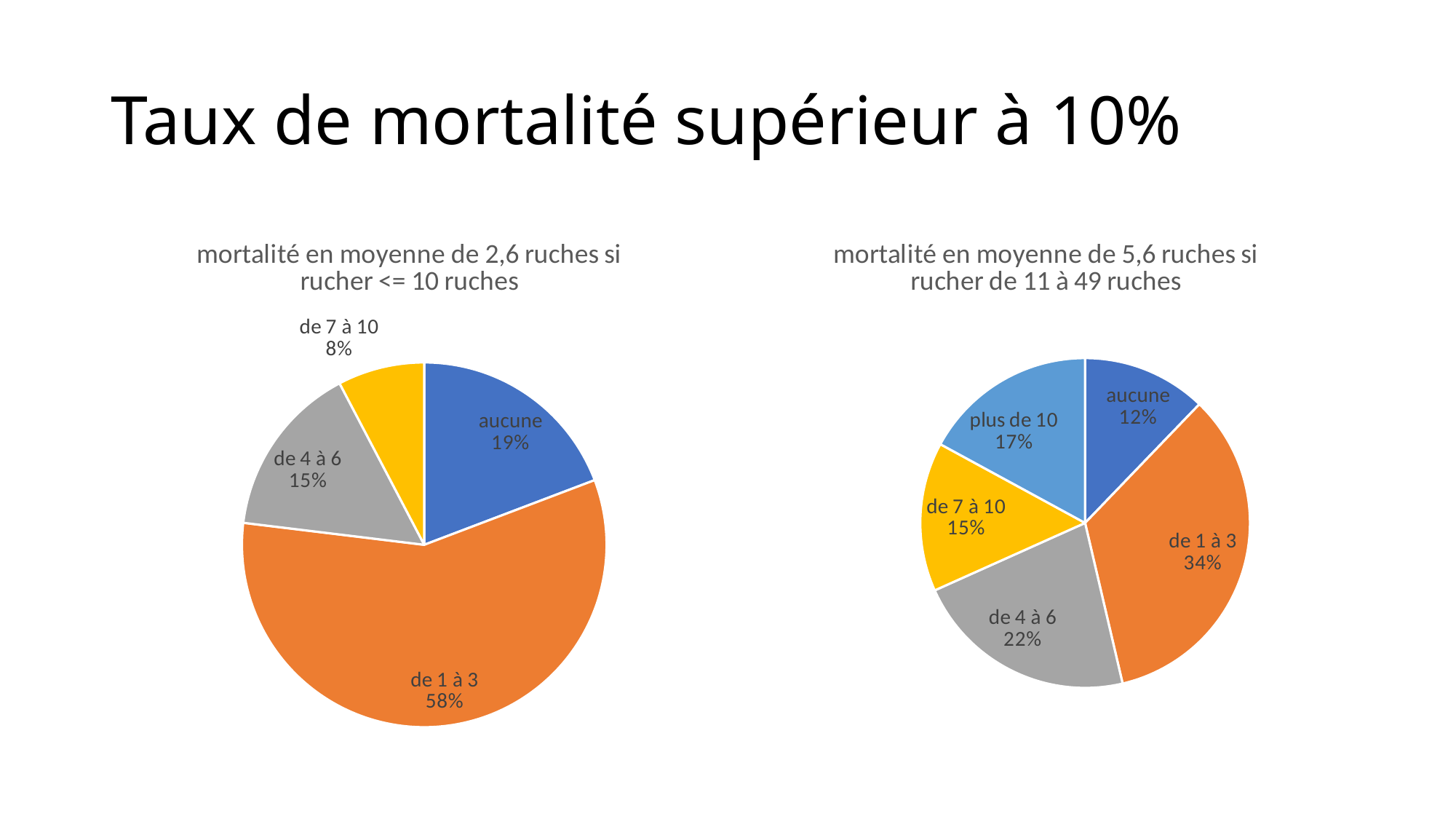
In the right pie chart (rucher de 11 à 49 ruches), what share does 'de 4 à 6' have? 22% In the right pie chart (rucher de 11 à 49 ruches), which category has the largest share? de 1 à 3 In the right pie chart (rucher de 11 à 49 ruches), what share does 'plus de 10' have? 17% In the right pie chart (rucher de 11 à 49 ruches), which category has the smallest share? aucune Which is larger: the share of 'de 7 à 10' in the left pie chart or in the right pie chart? right pie chart In the right pie chart (rucher de 11 à 49 ruches), how many slices are there? 5 What type of chart is used on this slide? pie chart In the left pie chart (rucher <= 10 ruches), which category has the smallest share? de 7 à 10 In the left pie chart (rucher <= 10 ruches), what share does 'aucune' have? 19% In the left pie chart (rucher <= 10 ruches), what is the difference between the shares of 'aucune' and 'de 4 à 6'? 4% In the left pie chart (rucher <= 10 ruches), how many slices are there? 4